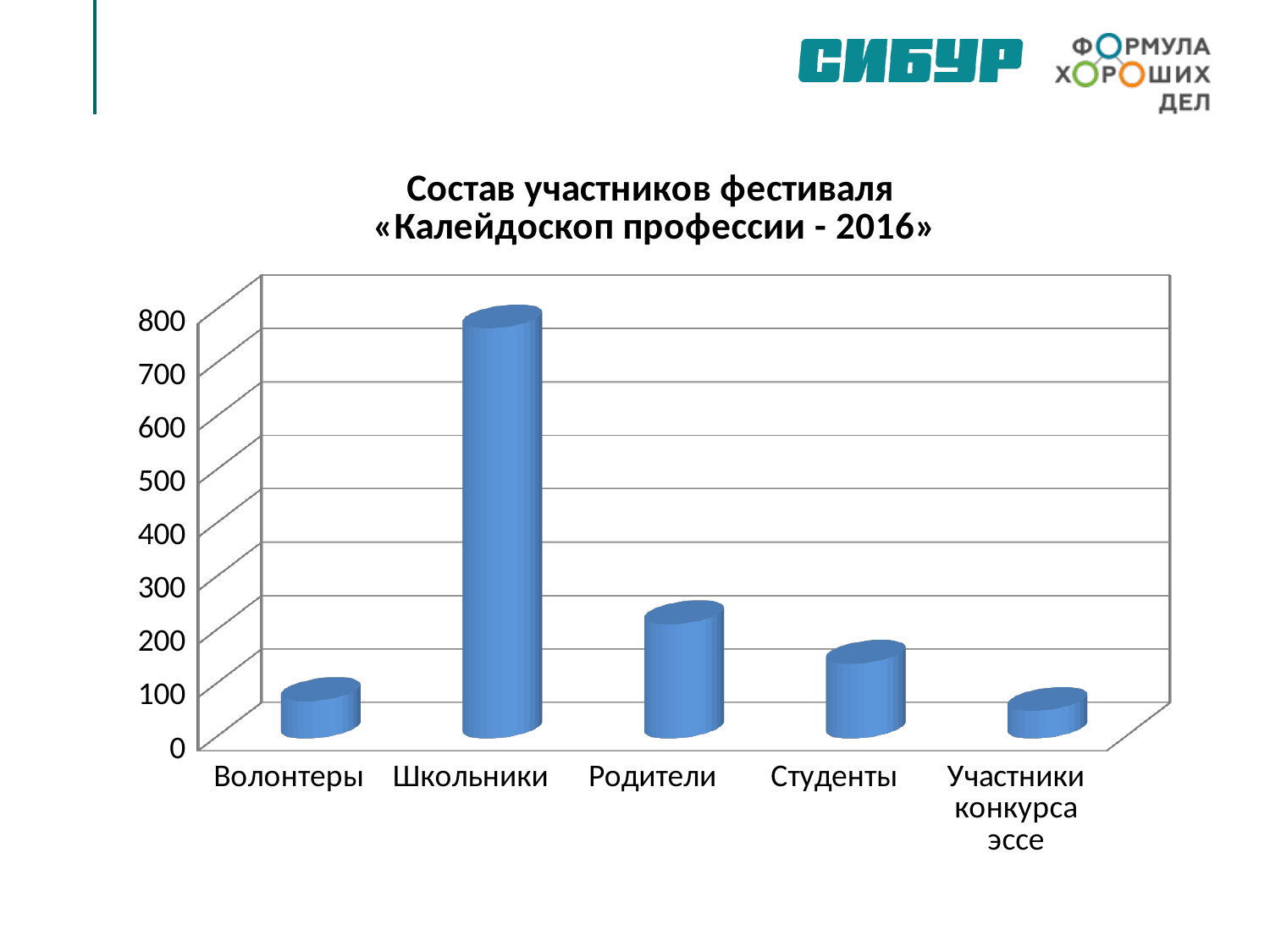
Which is larger, the value for Школьники or the value for Волонтеры? Школьники Is the value for Родители greater or less than 400? less Is the value for Волонтеры greater or less than 200? less Is the value for Студенты greater or less than 300? less What kind of chart is shown on the slide? bar chart Which category has the highest value? Школьники How many categories are shown on the x axis of the chart? 5 Which is larger, the value for Родители or the value for Студенты? Родители What is the title of the chart? Состав участников фестиваля «Калейдоскоп профессии - 2016»